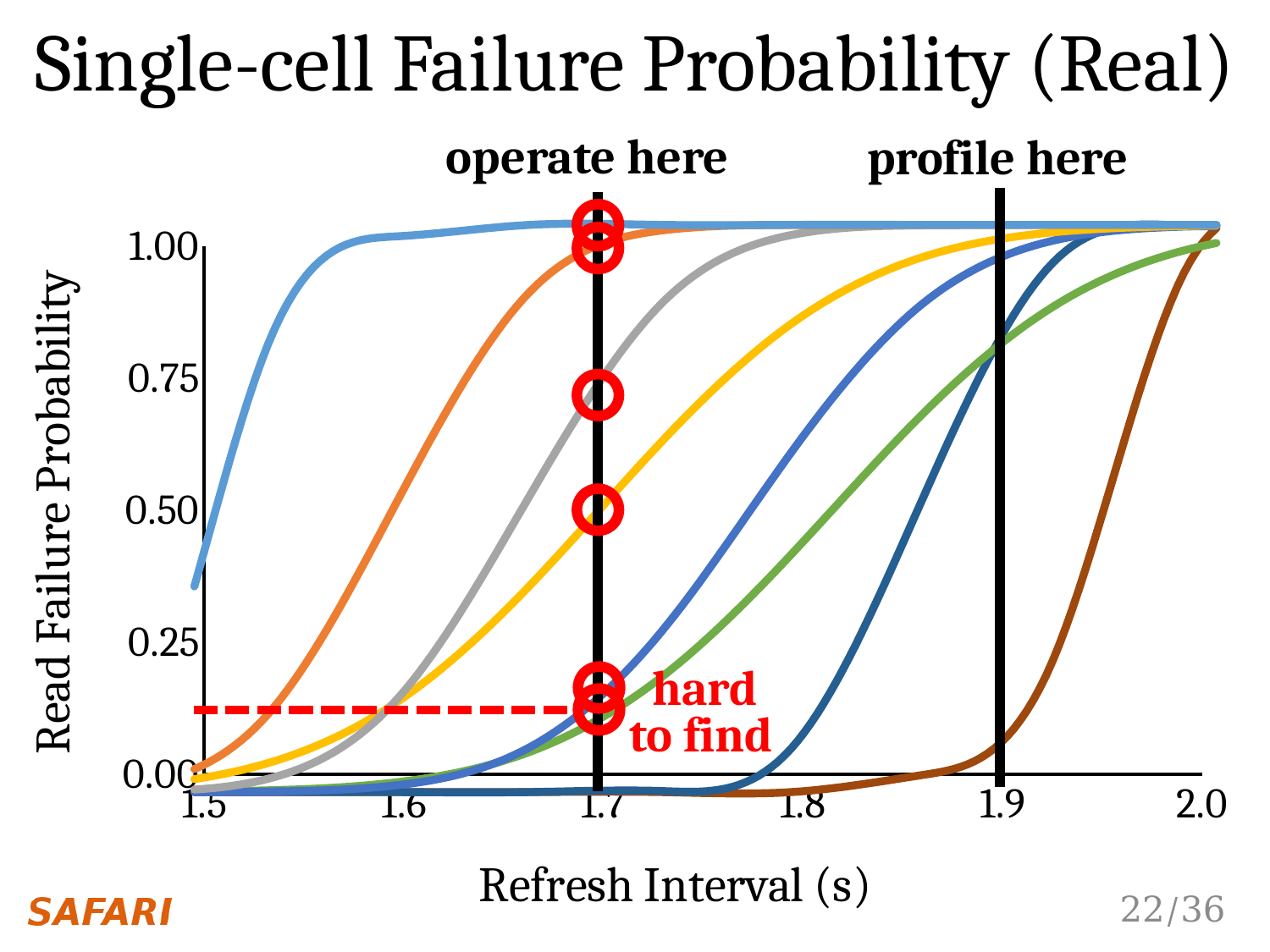
Is the value of the green curve at a refresh interval of 1.7 greater or less than 0.25? less At which refresh interval is the 'operate here' vertical line drawn? 1.7 Do the curves rise or fall as the refresh interval increases? rise What kind of chart is shown on the slide? line chart What is the title of the slide's chart? Single-cell Failure Probability (Real) Is the value of the orange curve at a refresh interval of 1.6 greater or less than 0.50? greater At which refresh interval is the 'profile here' vertical line drawn? 1.9 At a refresh interval of 1.9, which curve is higher: the light blue curve or the brown curve? light blue Is the value of the brown curve at a refresh interval of 1.9 greater or less than 0.25? less What is the highest tick value shown on the x axis? 2.0 What is the label of the x axis? Refresh Interval (s)